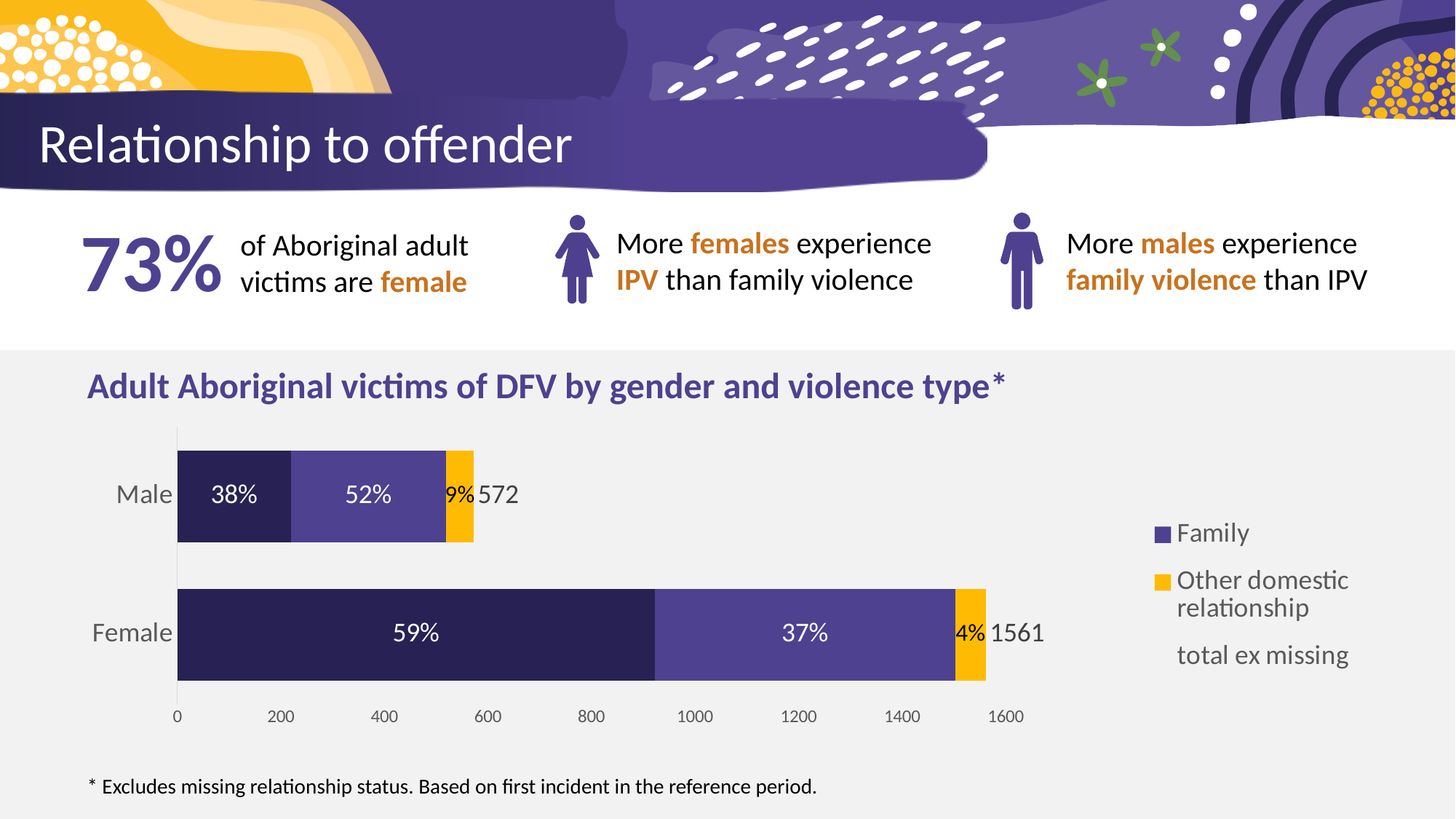
What percentage is printed on the first (leftmost) segment of the Female bar? 59% What percentage is printed on the yellow 'Other domestic relationship' segment of the Male bar? 9% What is the difference between the Female total (1561) and the Male total (572)? 989 Which gender has the larger total number of victims, Male or Female? Female What is the title of the chart? Adult Aboriginal victims of DFV by gender and violence type* How many categories (bars) does the chart show? 2 How many entries does the chart legend list? 3 What total (ex missing) is printed at the end of the Female bar? 1561 What percentage is printed on the middle segment of the Male bar? 52% What kind of chart is shown on the slide? bar chart Is the total for Male greater or less than 600? less What total (ex missing) is printed at the end of the Male bar? 572